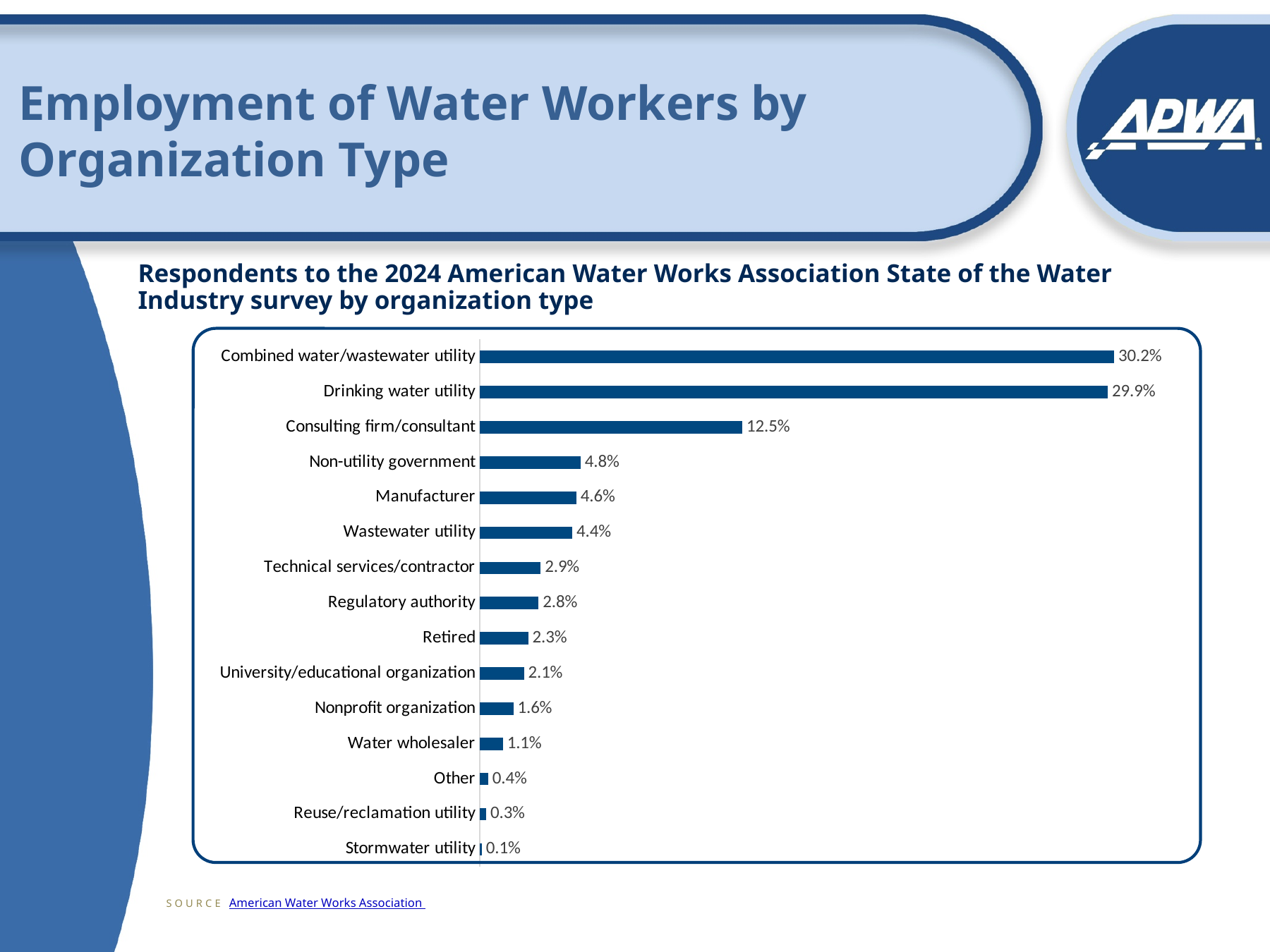
What is the value shown for Consulting firm/consultant? 12.5% What percentage of respondents work at a combined water/wastewater utility? 30.2% What is the difference between the Combined water/wastewater utility and Drinking water utility values? 0.3% What percentage is shown for Regulatory authority? 2.8% Which organization type has the highest share of respondents? Combined water/wastewater utility What is the difference between the Consulting firm/consultant and Non-utility government values? 7.7% What is the source cited for the chart? American Water Works Association What kind of chart is shown on the slide? Bar chart How many organization types are shown in the chart? 15 Which is larger, the value for Manufacturer or the value for Wastewater utility? Manufacturer Which is larger, the value for Retired or the value for Nonprofit organization? Retired Which organization type has the lowest share of respondents? Stormwater utility